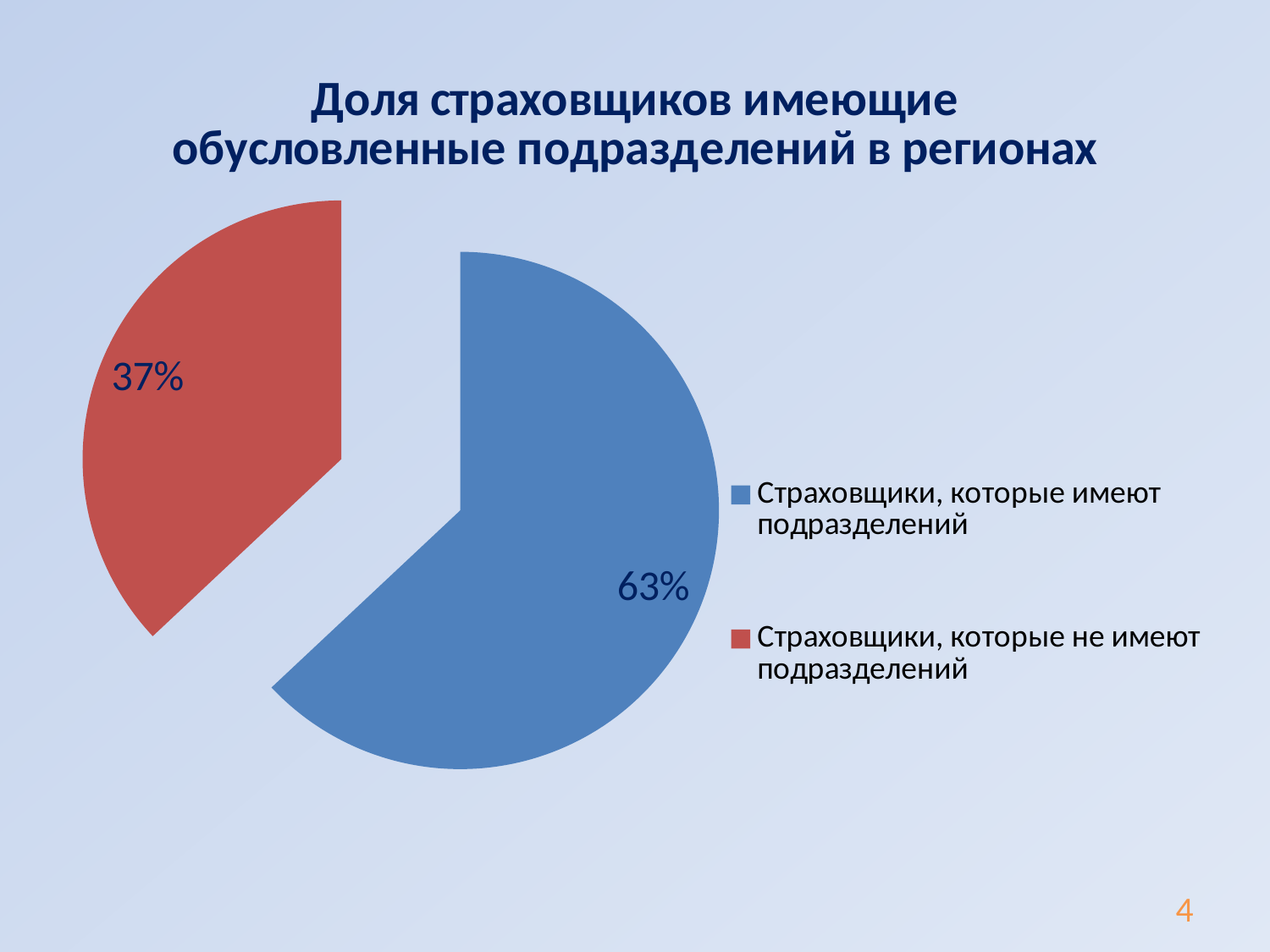
What share of the pie is labelled "Страховщики, которые имеют подразделений"? 63% Which is larger: the share of insurers with subdivisions or the share of insurers without subdivisions? Страховщики, которые имеют подразделений What share of the pie is labelled "Страховщики, которые не имеют подразделений"? 37% What colour is the slice for "Страховщики, которые не имеют подразделений"? Red What is the title of the chart? Доля страховщиков имеющие обусловленные подразделений в регионах How many entries does the legend list? 2 Is the share for "Страховщики, которые имеют подразделений" greater or less than 50%? greater Which slice of the pie is the largest? Страховщики, которые имеют подразделений What is the difference in percentage points between the slice for insurers with subdivisions and the slice for insurers without subdivisions? 26 How many slices does the pie chart have? 2 Which slice of the pie is the smallest? Страховщики, которые не имеют подразделений What kind of chart is shown on the slide? Pie chart